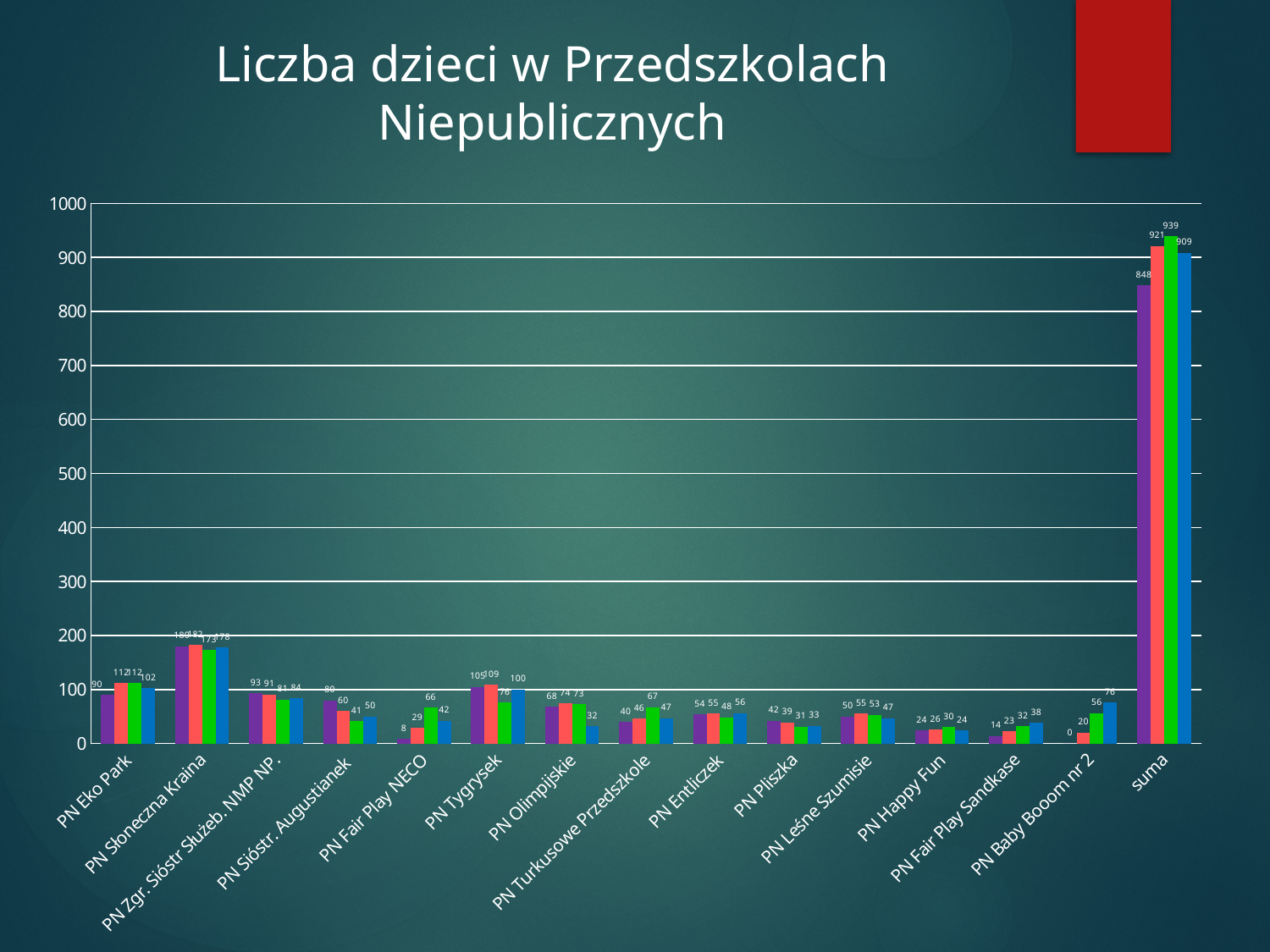
What is the value of the blue bar for PN Tygrysek? 100 What is the title of the chart? Liczba dzieci w Przedszkolach Niepublicznych Which category has the lowest purple bar? PN Baby Booom nr 2 What is the value of the green bar for suma? 939 What is the difference between the green bar (939) and the purple bar (848) for suma? 91 How many categories are shown along the x axis of the chart? 15 What is the value of the green bar for PN Fair Play NECO? 66 What kind of chart is shown on the slide? bar chart Which is larger for PN Olimpijskie: the red bar or the blue bar? the red bar Excluding suma, which category has the highest purple bar? PN Słoneczna Kraina What is the value of the purple bar for PN Baby Booom nr 2? 0 Is the value of the purple bar for suma greater or less than 900? less